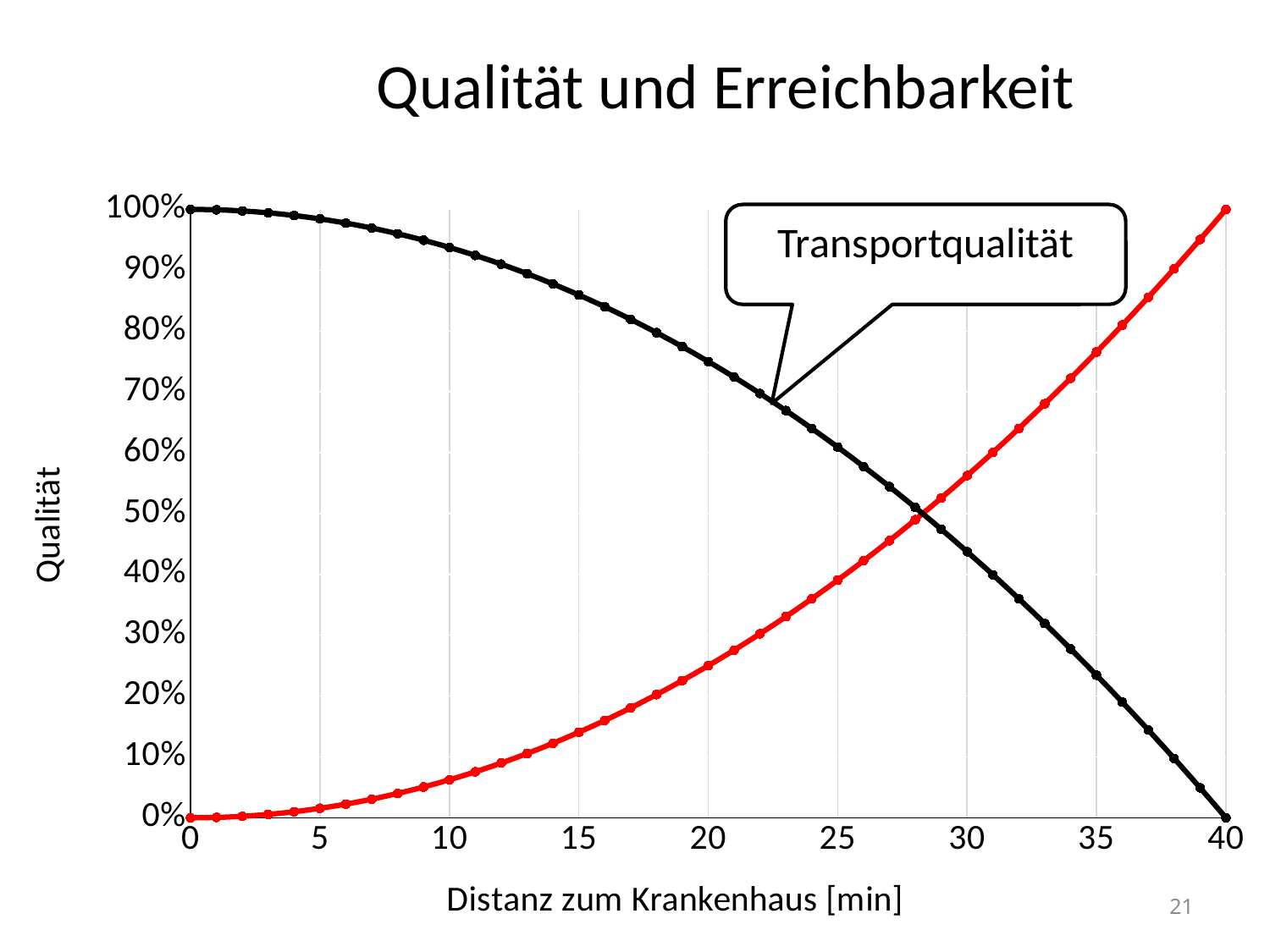
What is the title of the x axis? Distanz zum Krankenhaus [min] Does the red line rise or fall as the distance to the hospital increases? rise Is the value of the Transportqualität line at 30 minutes greater or less than 50%? less What kind of chart is shown on the slide? line chart What is the value of the red line at 40 minutes? 100% What is the value of the Transportqualität line at 0 minutes? 100% What is the value of the red line at 0 minutes? 0% Does the Transportqualität line rise or fall as the distance to the hospital increases? fall At 35 minutes, which line has the higher value, the red line or the Transportqualität line? the red line What is the value of the Transportqualität line at 40 minutes? 0% Is the value of the red line at 30 minutes greater or less than 50%? greater Is the value of the Transportqualität line at 10 minutes greater or less than 90%? greater